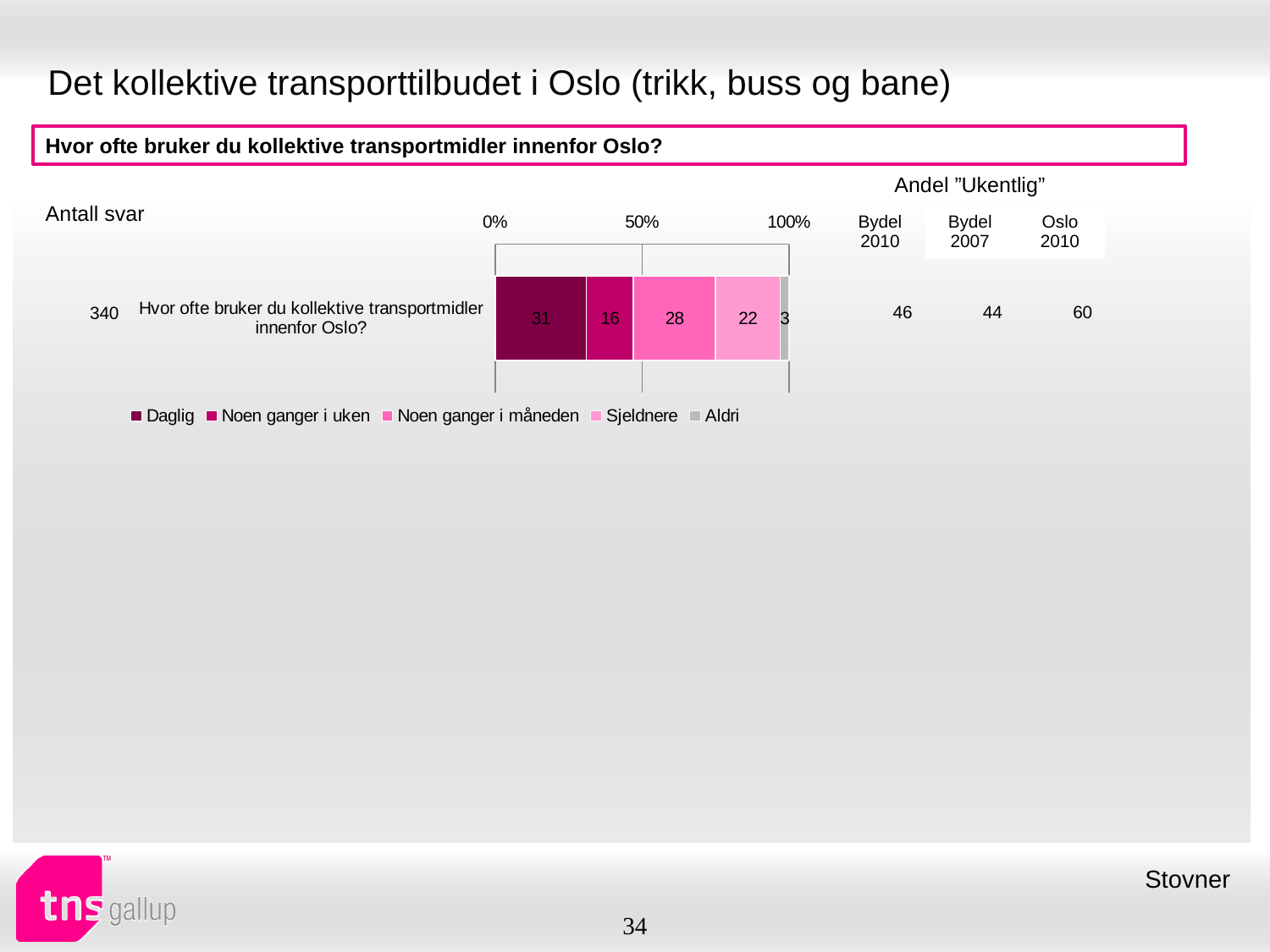
What is the value for "Noen ganger i måneden" in the bar? 28 What is the total of all segments in the stacked bar? 100 Which is larger, the "Noen ganger i måneden" value or the "Noen ganger i uken" value? Noen ganger i måneden Which series has the largest segment in the bar? Daglig How many series does the chart legend list? 5 What is the value for "Sjeldnere" in the bar? 22 What is the value for "Daglig" in the bar? 31 What is the value for "Aldri" in the bar? 3 What kind of chart is shown on the slide? stacked bar chart What is the value for "Noen ganger i uken" in the bar? 16 Which series has the smallest segment in the bar? Aldri What is the difference between the "Daglig" and "Sjeldnere" values? 9